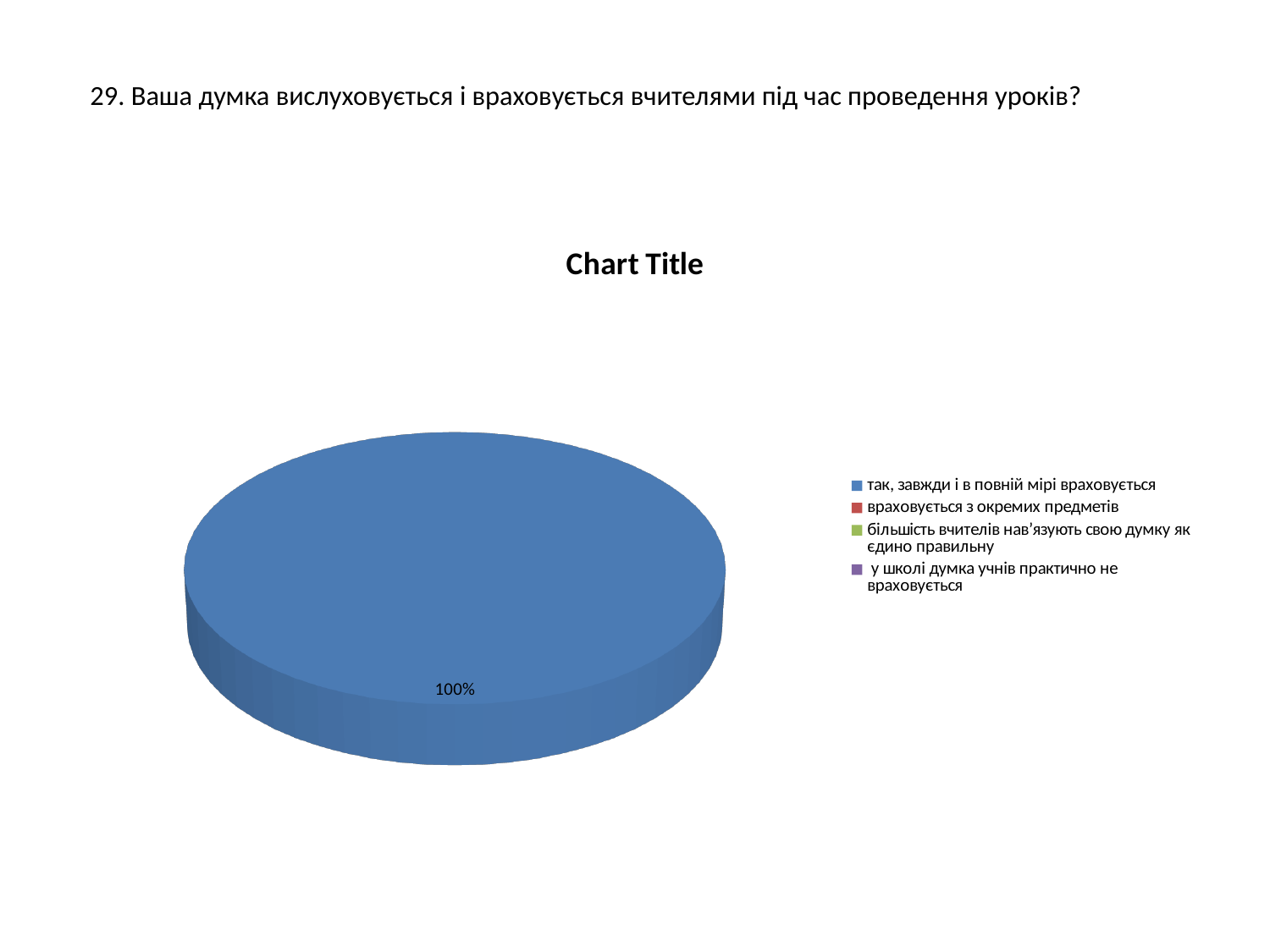
What kind of chart is shown on the slide? pie chart What percentage is printed on the pie chart? 100% Is the value shown on the pie chart greater or less than 50%? greater Which legend entry is listed second? враховується з окремих предметів What share of the pie does the slice for "так, завжди і в повній мірі враховується" take? 100% What is the title of the chart? Chart Title Which category has the largest share of the pie? так, завжди і в повній мірі враховується How many entries does the chart legend list? 4 How many slices are visible in the pie chart? 1 What colour is the slice labelled 100%? blue